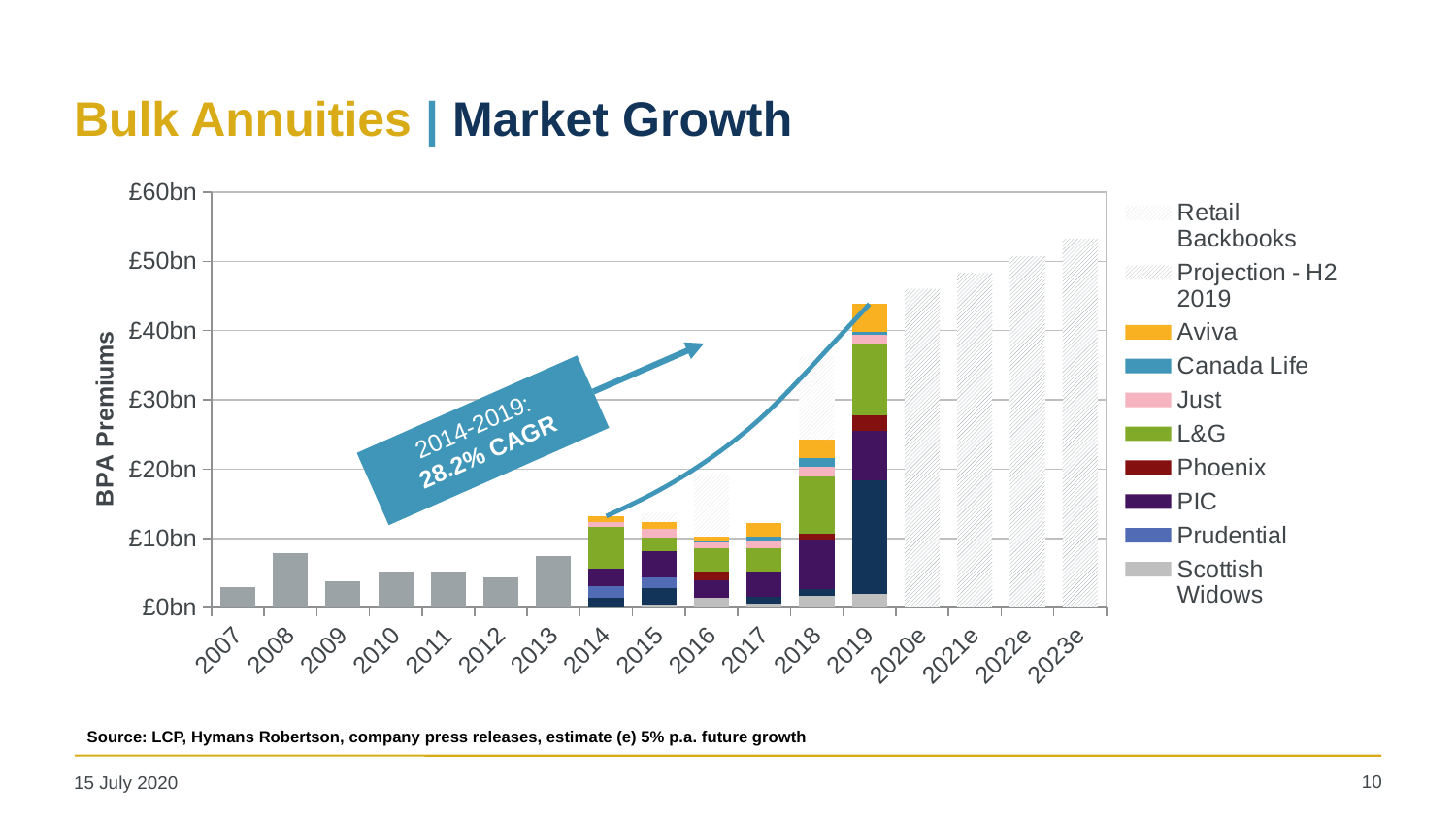
Which year has the tallest bar on the chart? 2023e How many entries does the legend list? 10 Is the value for 2008 greater or less than £10bn? less Which bar is taller, 2019 or 2018? 2019 Is the value for 2023e greater or less than £50bn? greater How many years (categories) are shown along the x axis? 17 What kind of chart is shown on the slide? Stacked bar chart Is the total value for 2018 greater or less than £20bn? greater Which bar is taller, 2007 or 2008? 2008 Do the bar totals rise or fall from 2014 to 2019? Rise What CAGR for 2014-2019 is stated in the annotation on the chart? 28.2%